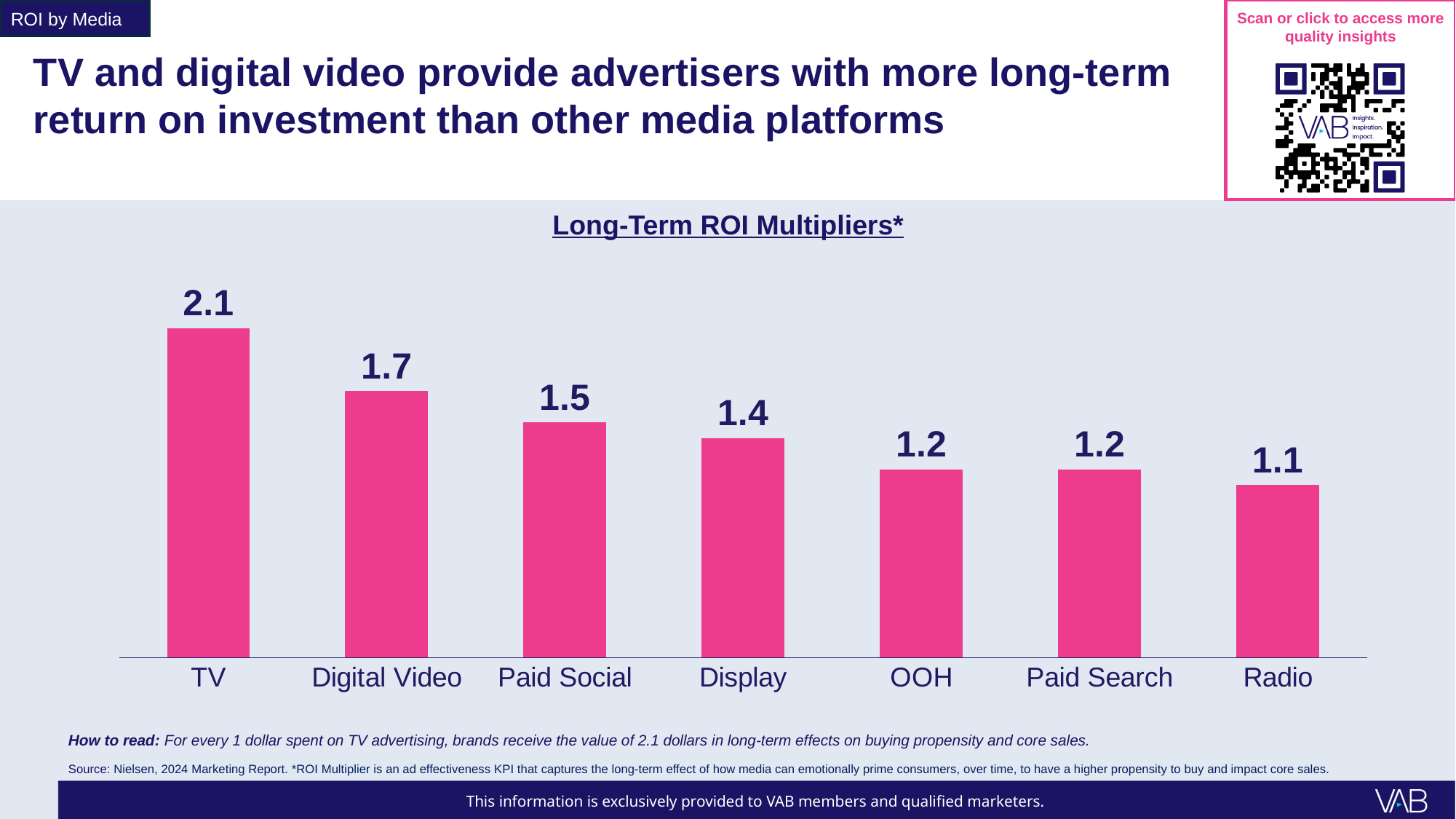
How many media platforms are shown in the chart? 7 Which media platform has the lowest long-term ROI multiplier? Radio What is the long-term ROI multiplier for Radio? 1.1 Which has a larger ROI multiplier, Paid Social or Display? Paid Social What is the long-term ROI multiplier for TV? 2.1 What is the difference between the ROI multipliers for TV and Paid Social? 0.6 What is the long-term ROI multiplier for Digital Video? 1.7 What is the difference between the ROI multipliers for Digital Video and Radio? 0.6 What kind of chart is shown on the slide? Bar chart What is the long-term ROI multiplier for Display? 1.4 What is the title of the chart? Long-Term ROI Multipliers* Which media platform has the highest long-term ROI multiplier? TV